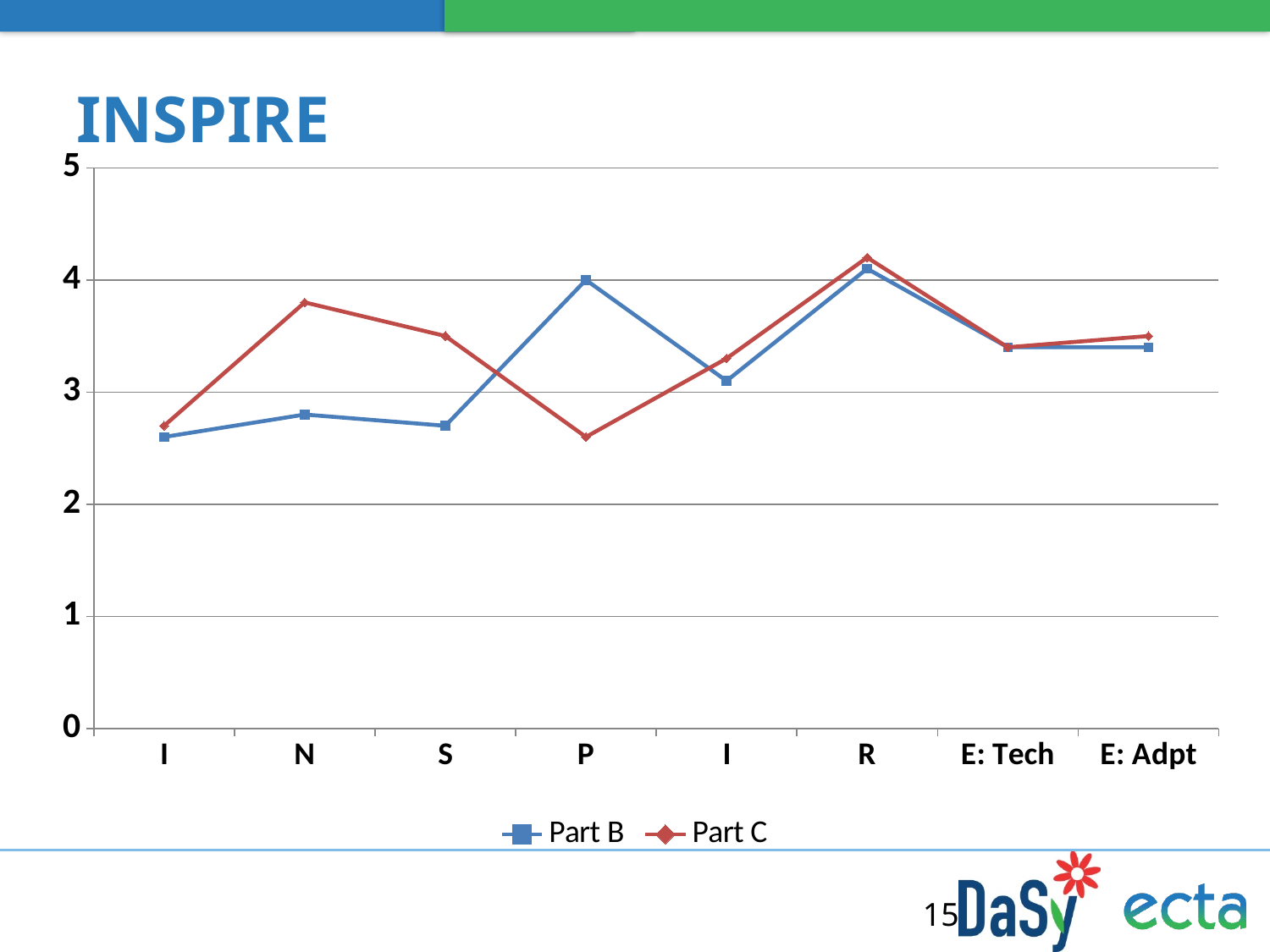
What kind of chart is shown on the slide? line chart What is the title of the chart? INSPIRE Is the value for Part C at N greater or less than 3? greater At P, which series has the larger value, Part B or Part C? Part B For which category does Part C reach its highest value? R Is the value for Part C at P greater or less than 3? less Which series is drawn in blue with square markers? Part B How many series does the legend list? 2 At N, which series has the larger value, Part B or Part C? Part C Is the value for Part C at R greater or less than 4? greater How many categories are shown along the x axis? 8